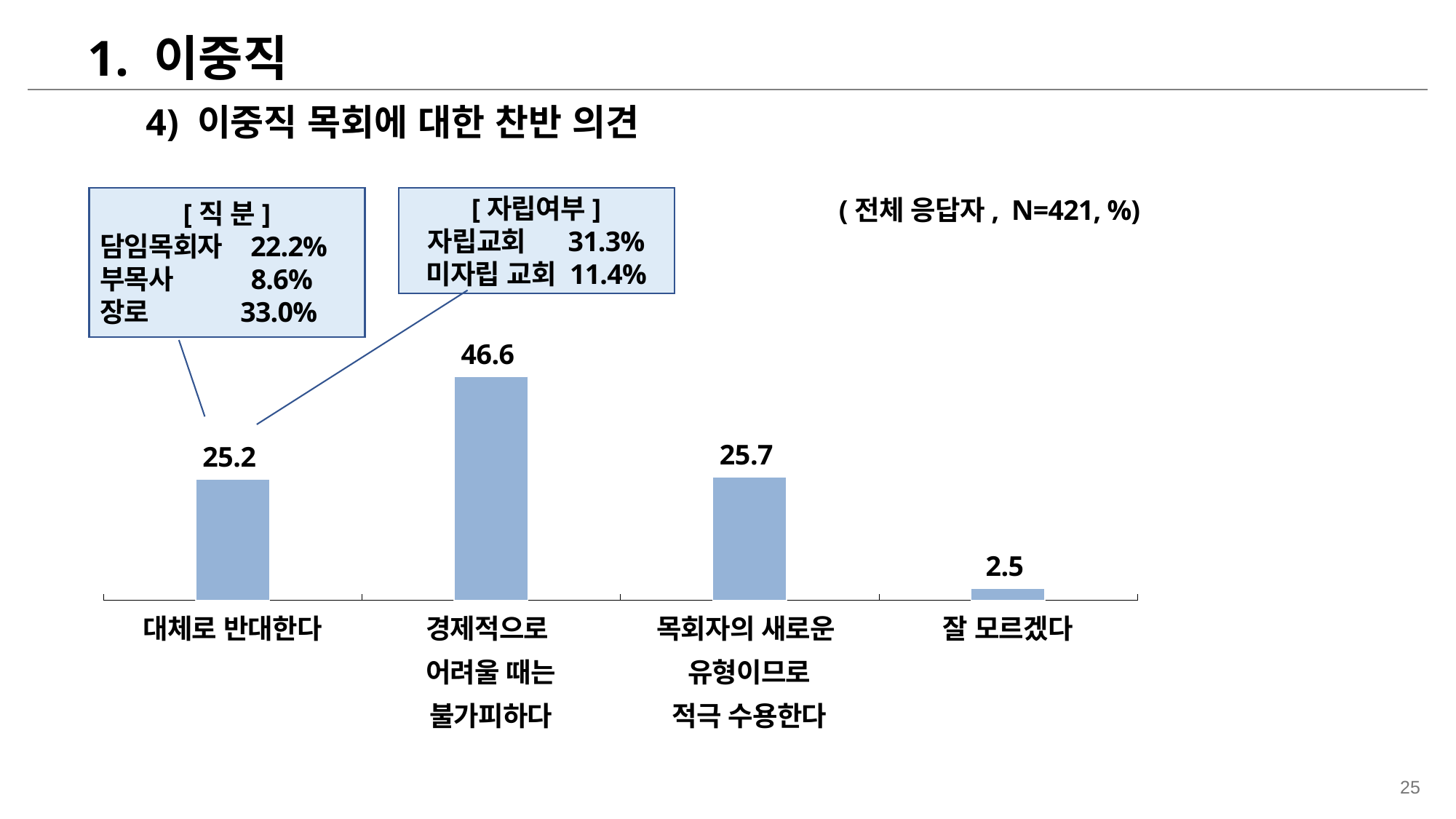
What is the value for 경제적으로 어려울 때는 불가피하다? 46.6 What is the value for 잘 모르겠다? 2.5 Which is larger, the value for 경제적으로 어려울 때는 불가피하다 or the value for 잘 모르겠다? 경제적으로 어려울 때는 불가피하다 What is the value for 목회자의 새로운 유형이므로 적극 수용한다? 25.7 What kind of chart is shown on the slide? Bar chart What is the difference between the values for 목회자의 새로운 유형이므로 적극 수용한다 and 잘 모르겠다? 23.2 Which category has the lowest value? 잘 모르겠다 Which category has the highest value? 경제적으로 어려울 때는 불가피하다 How many categories are shown in the chart? 4 What is the difference between the values for 경제적으로 어려울 때는 불가피하다 and 대체로 반대한다? 21.4 According to the 직분 callout box, what is the value for 장로? 33.0% What is the value for 대체로 반대한다? 25.2